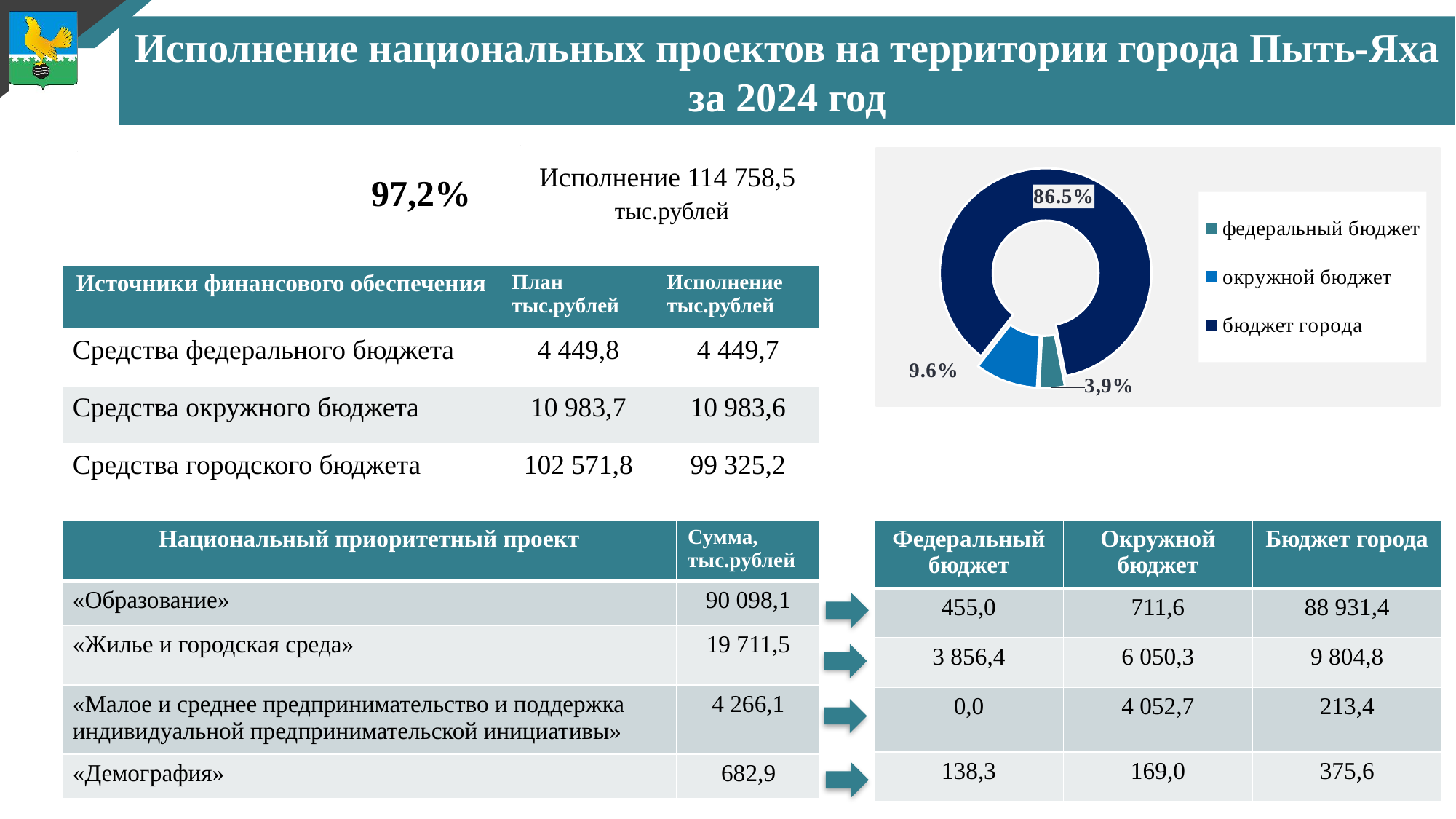
Which slice of the doughnut chart is the smallest? федеральный бюджет In the doughnut chart, which is larger: «окружной бюджет» or «федеральный бюджет»? окружной бюджет Which legend entry of the doughnut chart is listed first? федеральный бюджет What share of the doughnut chart does «бюджет города» take? 86.5% What kind of chart is shown on the slide? doughnut (pie) chart What colour is the «бюджет города» slice in the doughnut chart? dark navy blue How many series does the legend of the doughnut chart list? 3 Is the share of «бюджет города» in the doughnut chart greater or less than 50%? greater What share of the doughnut chart does «федеральный бюджет» take? 3,9% How many slices does the doughnut chart have? 3 What share of the doughnut chart does «окружной бюджет» take? 9.6% Which slice of the doughnut chart is the largest? бюджет города